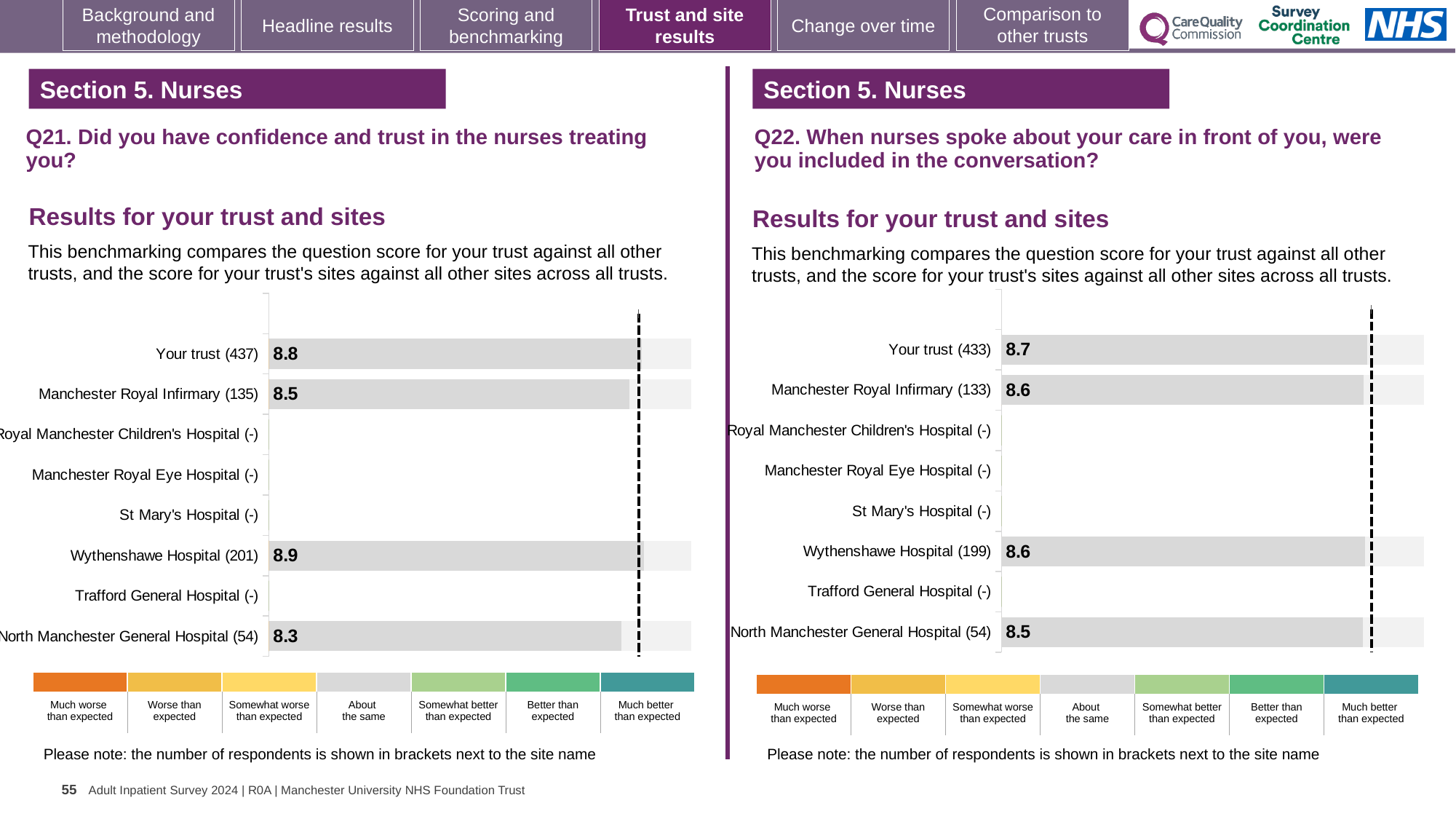
In the Q21 chart on the left, what is the score for Your trust (437)? 8.8 In the Q22 chart on the right, what is the score for Your trust (433)? 8.7 In the Q21 chart on the left, which site has the lowest score? North Manchester General Hospital (54) In the Q21 chart on the left, what is the score for Wythenshawe Hospital (201)? 8.9 In the Q22 chart on the right, what is the score for North Manchester General Hospital (54)? 8.5 In the Q21 chart on the left, what is the difference between the scores for Wythenshawe Hospital and North Manchester General Hospital? 0.6 What type of chart is used for the Q22 results on the right? Bar chart In the Q22 chart on the right, which site has the highest score? Your trust (433) In the Q22 chart on the right, what is the difference between the scores for Your trust and North Manchester General Hospital? 0.2 How many site labels are listed on the y axis of the Q21 chart on the left? 8 In the Q21 chart on the left, which is higher: Manchester Royal Infirmary or Your trust? Your trust How many categories does the colour key below the Q21 chart on the left show? 7